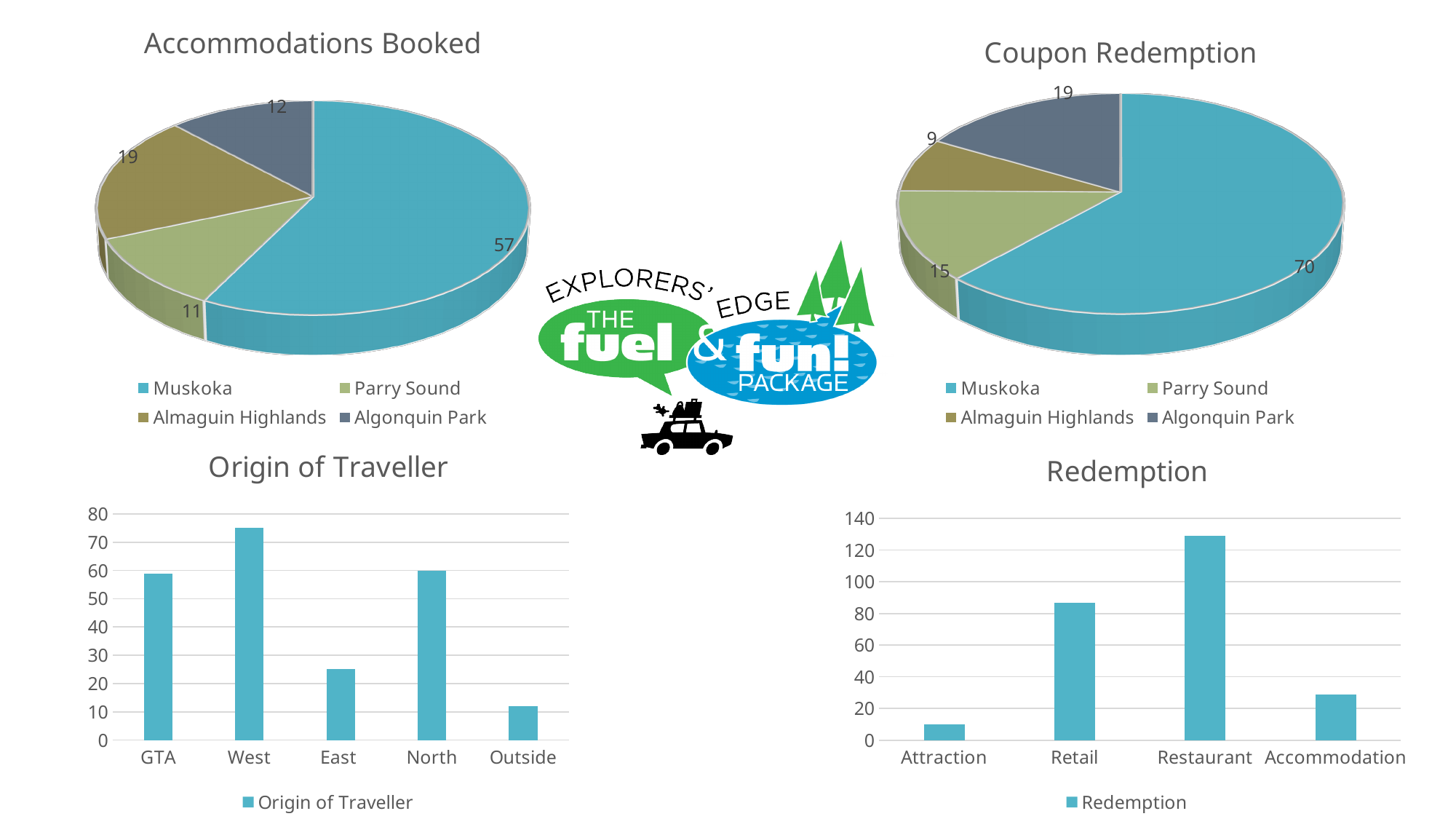
In the Accommodations Booked pie chart, what is the difference between the values for Muskoka and Almaguin Highlands? 38 In the Coupon Redemption pie chart, which category has the largest slice? Muskoka How many categories are shown on the x axis of the Redemption bar chart? 4 In the Coupon Redemption pie chart, what is the value for Almaguin Highlands? 9 In the Redemption bar chart, is the value for Restaurant greater or less than 120? greater In the Redemption bar chart, which category has the lowest bar? Attraction In the Accommodations Booked pie chart, which category has the smallest slice? Parry Sound In the Accommodations Booked pie chart, what is the value for Muskoka? 57 In the Coupon Redemption pie chart, what is the difference between the values for Muskoka and Algonquin Park? 51 In the Accommodations Booked pie chart, what is the value for Parry Sound? 11 In the Origin of Traveller bar chart, is the value for East greater or less than 30? less In the Origin of Traveller bar chart, which category has the highest bar? West